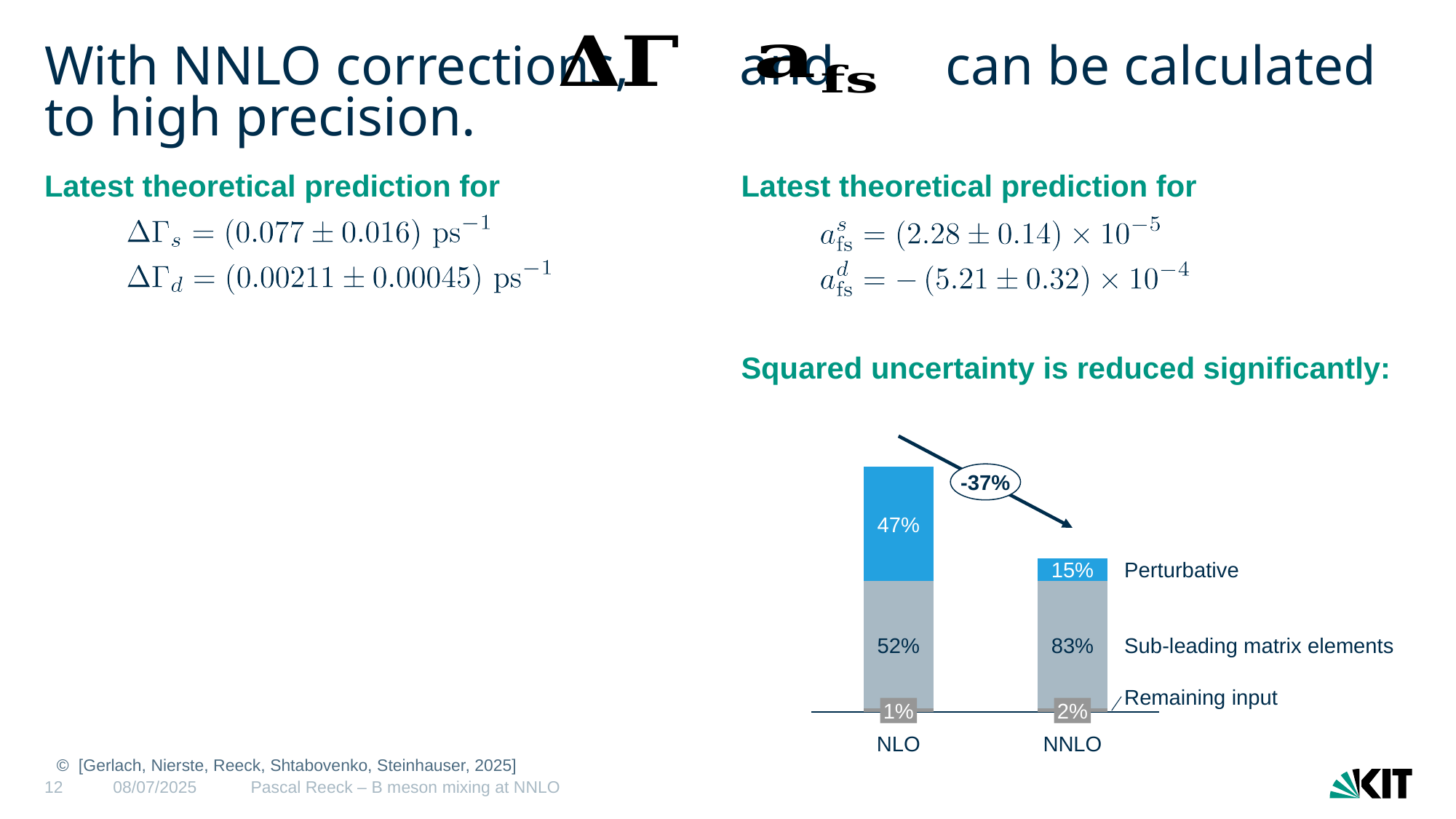
What is the Remaining input share of the NLO bar? 1% Which bar has the larger Sub-leading matrix elements share, NLO or NNLO? NNLO By how many percentage points does the Perturbative share differ between NLO and NNLO? 32 What is the Sub-leading matrix elements share of the NLO bar? 52% Which segment is the largest in the NNLO bar? Sub-leading matrix elements What percentage change is written in the oval annotation above the bars? -37% What is the Perturbative share of the NLO bar? 47% How many categories are shown on the x axis of the chart? 2 How many series (segment types) are labelled in the chart? 3 What kind of chart is shown on the slide? stacked bar chart What is the Perturbative share of the NNLO bar? 15% What is the Sub-leading matrix elements share of the NNLO bar? 83%